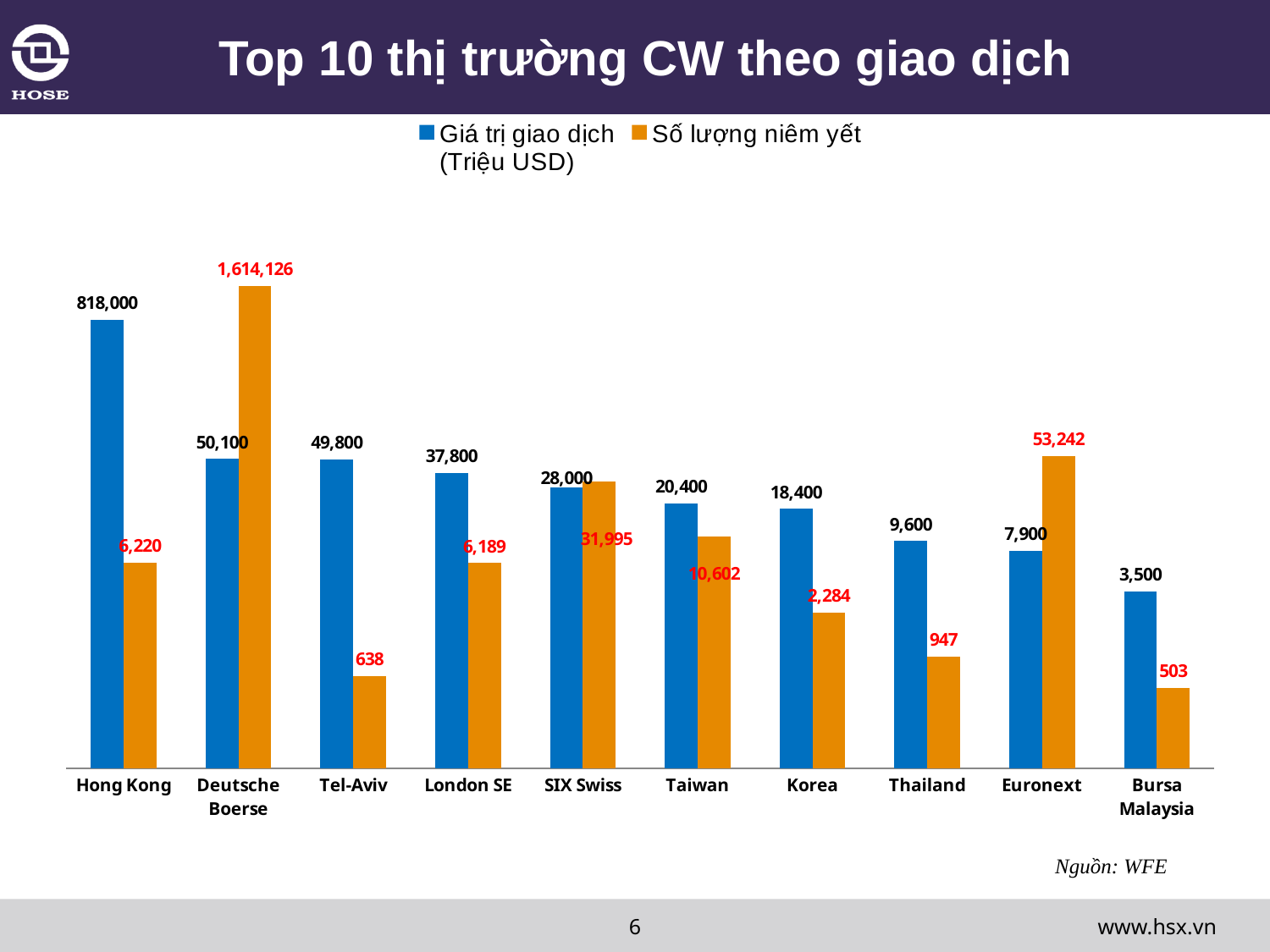
How many series does the legend list? 2 What is the Số lượng niêm yết value for Tel-Aviv? 638 How many markets are shown on the x axis? 10 Which has a larger Số lượng niêm yết, Euronext or SIX Swiss? Euronext What is the title of the slide? Top 10 thị trường CW theo giao dịch Which market has the lowest Số lượng niêm yết? Bursa Malaysia What is the difference between the Giá trị giao dịch (Triệu USD) values for Deutsche Boerse and Tel-Aviv? 300 What kind of chart is shown on the slide? Bar chart Which market has the highest Giá trị giao dịch (Triệu USD)? Hong Kong What is the Giá trị giao dịch (Triệu USD) value for Hong Kong? 818,000 What is the Giá trị giao dịch (Triệu USD) value for Bursa Malaysia? 3,500 What is the Số lượng niêm yết value for Deutsche Boerse? 1,614,126